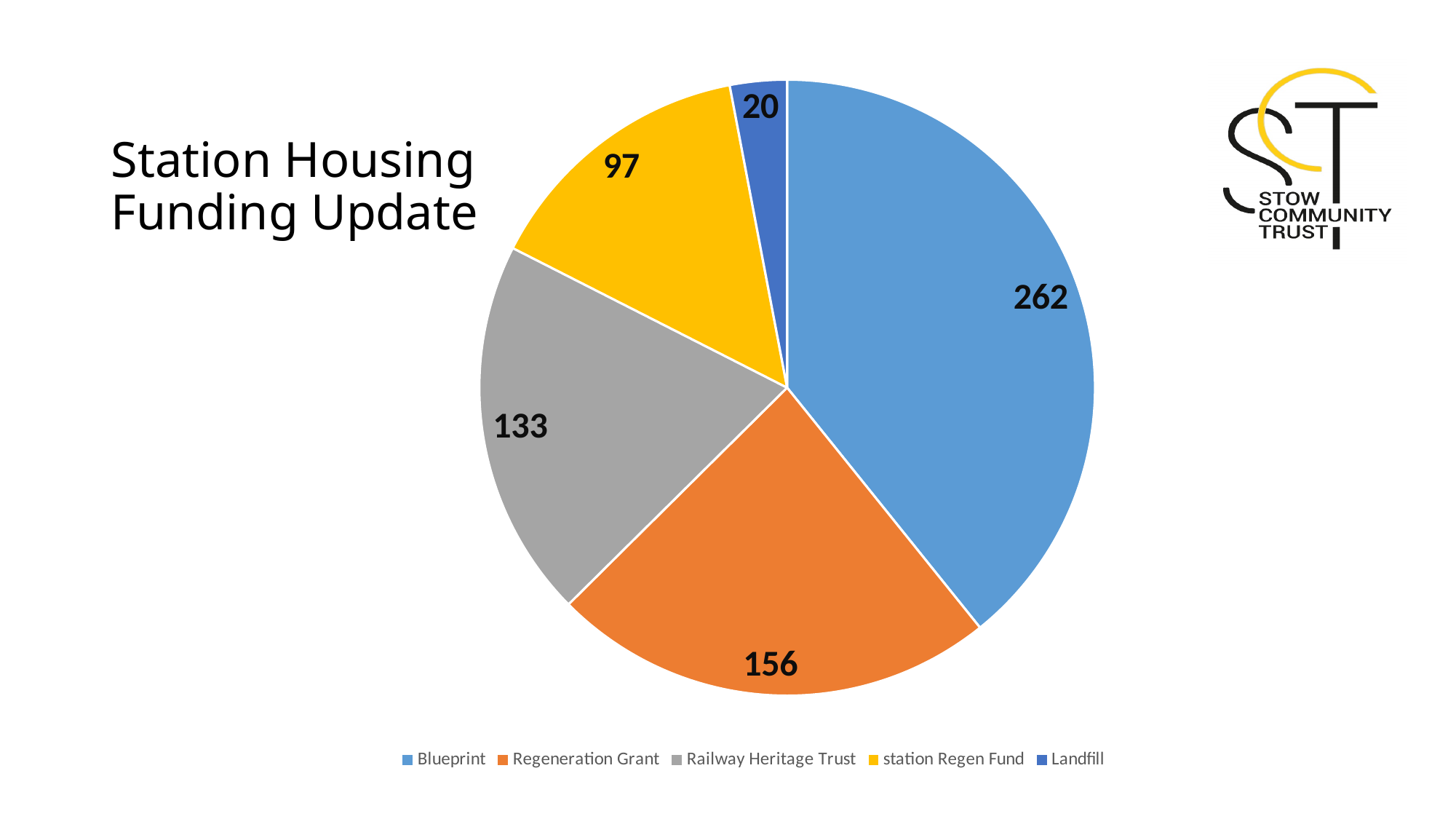
Which is larger, Regeneration Grant or Railway Heritage Trust? Regeneration Grant What is the value for Blueprint in the pie chart? 262 What type of chart is shown on the slide? Pie chart Which colour represents station Regen Fund in the legend? Yellow What is the difference between the station Regen Fund value and the Landfill value? 77 Which funding source has the smallest slice of the pie? Landfill What is the difference between the Blueprint value and the Regeneration Grant value? 106 How many slices does the pie chart have? 5 What is the total of all the slices in the pie chart? 668 What is the value for Railway Heritage Trust? 133 What is the value for Landfill? 20 Which funding source has the largest slice of the pie? Blueprint